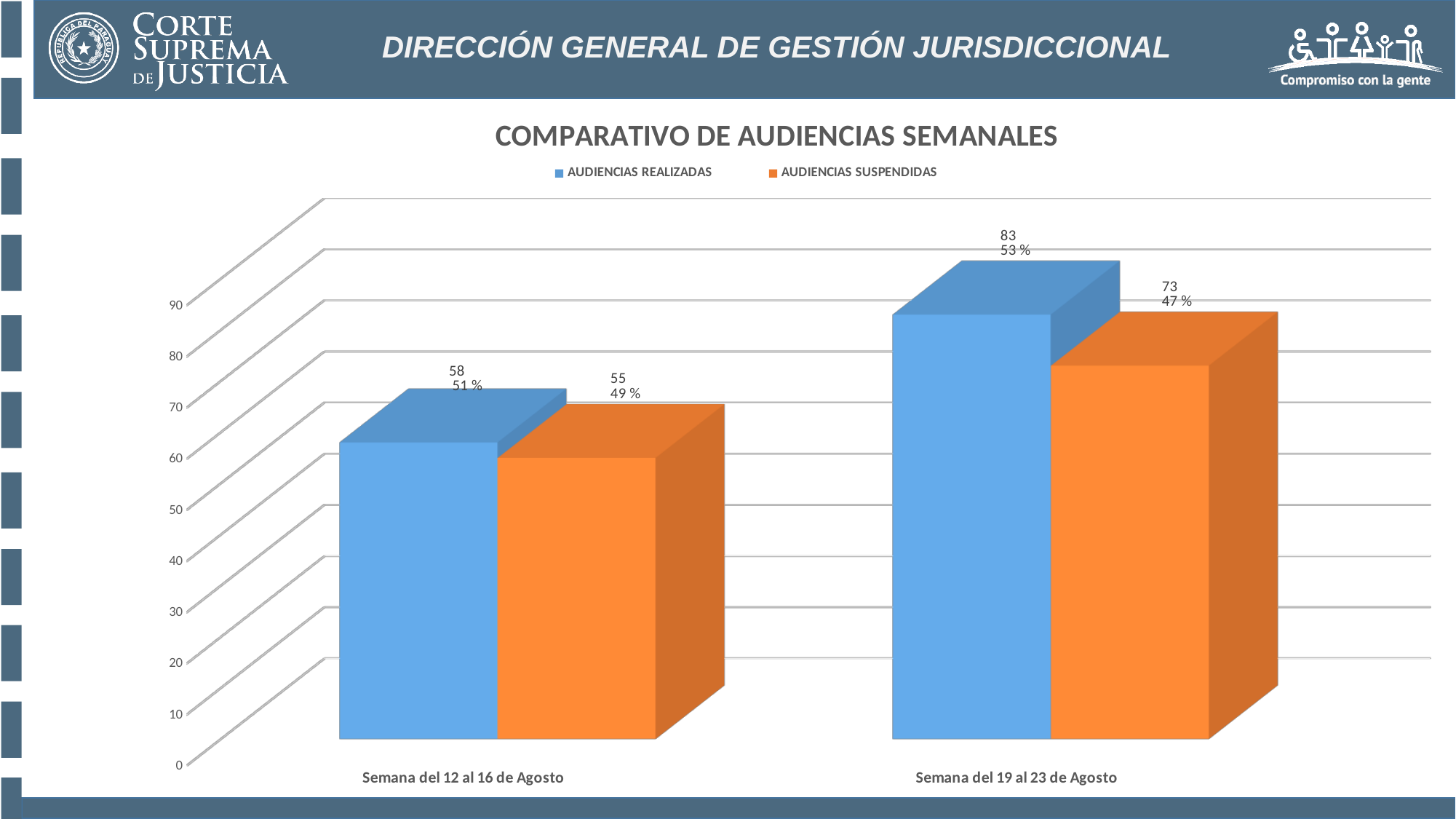
Which week has the highest value for AUDIENCIAS REALIZADAS? Semana del 19 al 23 de Agosto What percentage label is shown for AUDIENCIAS SUSPENDIDAS in Semana del 12 al 16 de Agosto? 49 % How many series does the legend list? 2 What is the value of AUDIENCIAS SUSPENDIDAS for Semana del 19 al 23 de Agosto? 73 How many weeks (categories) are shown on the x axis? 2 What percentage label is shown for AUDIENCIAS REALIZADAS in Semana del 19 al 23 de Agosto? 53 % What is the value of AUDIENCIAS REALIZADAS for Semana del 12 al 16 de Agosto? 58 In Semana del 19 al 23 de Agosto, which is larger: AUDIENCIAS REALIZADAS or AUDIENCIAS SUSPENDIDAS? AUDIENCIAS REALIZADAS What kind of chart is shown on the slide? Bar chart What is the title of the chart? COMPARATIVO DE AUDIENCIAS SEMANALES What is the difference between AUDIENCIAS REALIZADAS in Semana del 19 al 23 de Agosto and Semana del 12 al 16 de Agosto? 25 Which week has the lowest value for AUDIENCIAS SUSPENDIDAS? Semana del 12 al 16 de Agosto